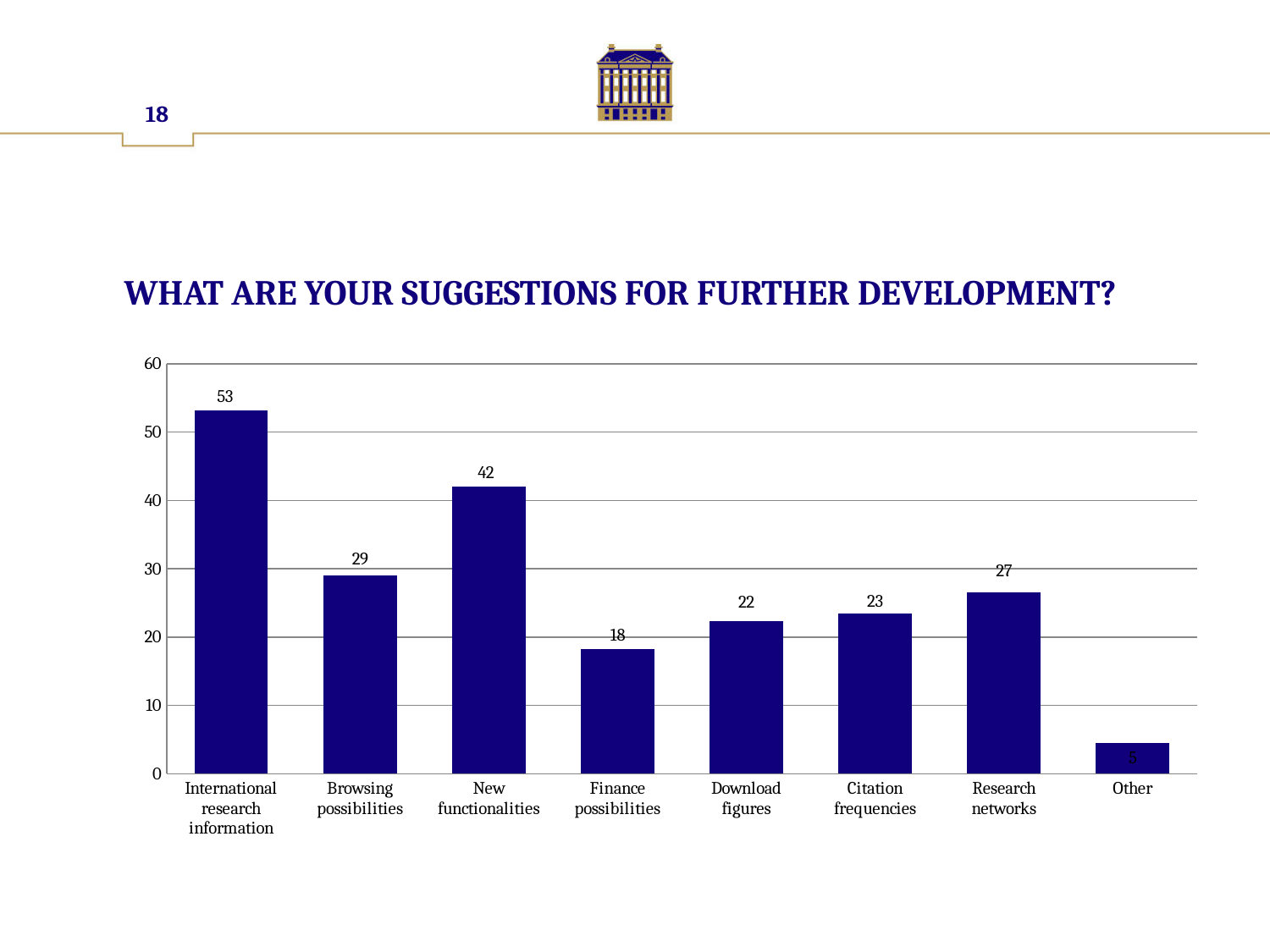
Which category has the lowest value? Other What is the value for International research information? 53 How many categories are shown on the x axis? 8 What is the value for Finance possibilities? 18 Which is larger, the value for Browsing possibilities or the value for Research networks? Browsing possibilities What is the title of the slide above the chart? WHAT ARE YOUR SUGGESTIONS FOR FURTHER DEVELOPMENT? Is the value for Citation frequencies greater or less than 30? less Which category has the highest value? International research information What is the value for New functionalities? 42 What kind of chart is shown on the slide? bar chart What is the value for Other? 5 What is the difference between the values for International research information and New functionalities? 11